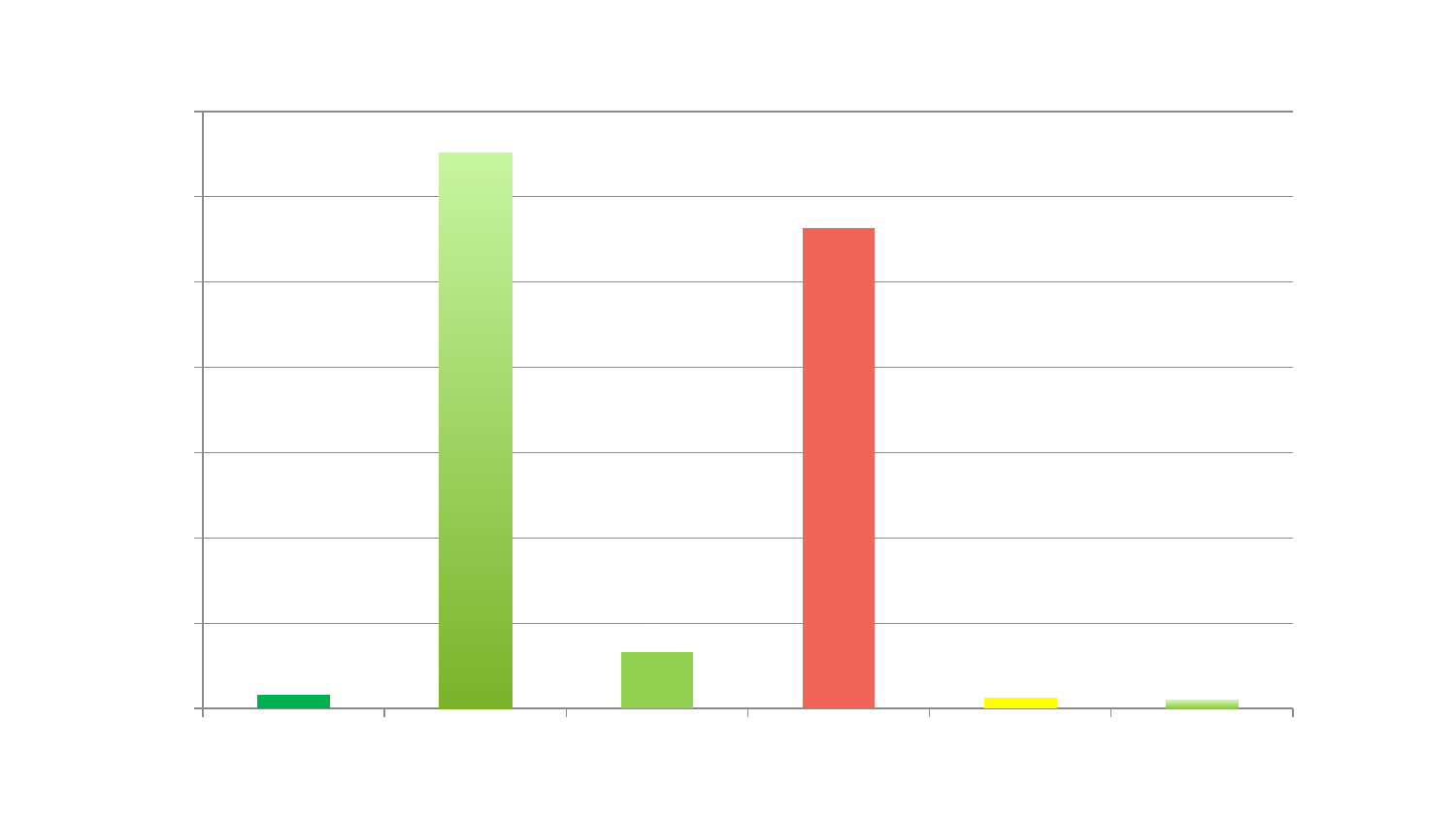
Is the third bar from the left taller or shorter than the fourth bar from the left? shorter Is the second bar from the left taller or shorter than the fourth bar from the left? taller What colour is the fourth bar from the left? red What kind of chart is shown on the slide? bar chart Which bar, counted from the left, is the tallest? the second bar Which bar, counted from the left, is the second tallest? the fourth bar What colour is the fifth bar from the left? yellow Is the first bar from the left taller or shorter than the third bar from the left? shorter How many bars are plotted in the chart? 6